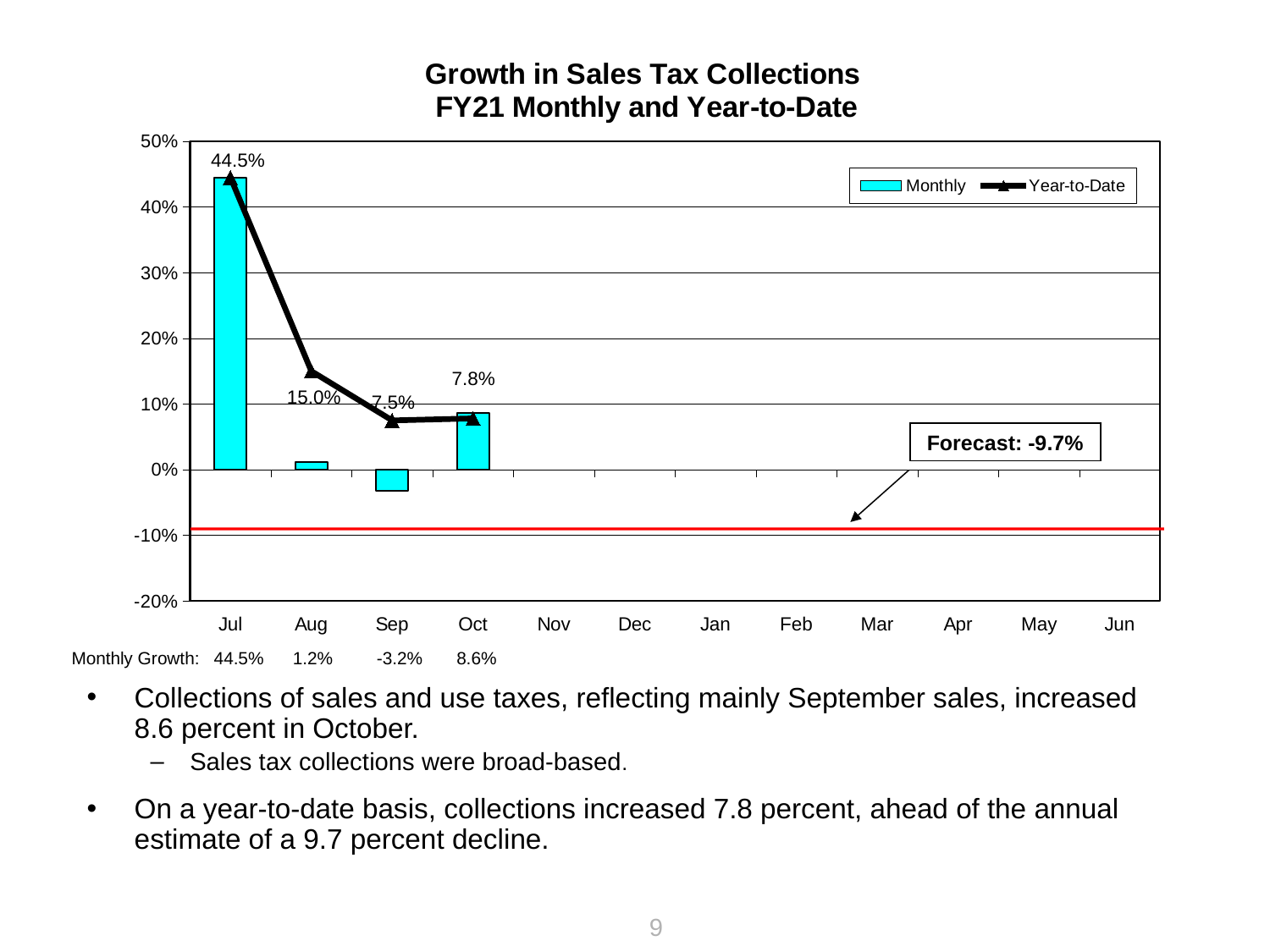
What is the Monthly growth value for Oct? 8.6% Which month has the lowest Year-to-Date value among those plotted? Sep Does the Year-to-Date line fall or rise from Jul to Sep? fall How many months have Monthly growth values plotted? 4 What is the Year-to-Date value for Jul? 44.5% What forecast value is shown on the chart? -9.7% What is the Monthly growth value for Sep? -3.2% Which is larger, the Monthly growth for Aug or for Oct? Oct What is the Year-to-Date value for Oct? 7.8% How many series does the legend list? 2 What is the difference between the Year-to-Date values for Jul and Aug? 29.5% Which month has the lowest Monthly growth value? Sep